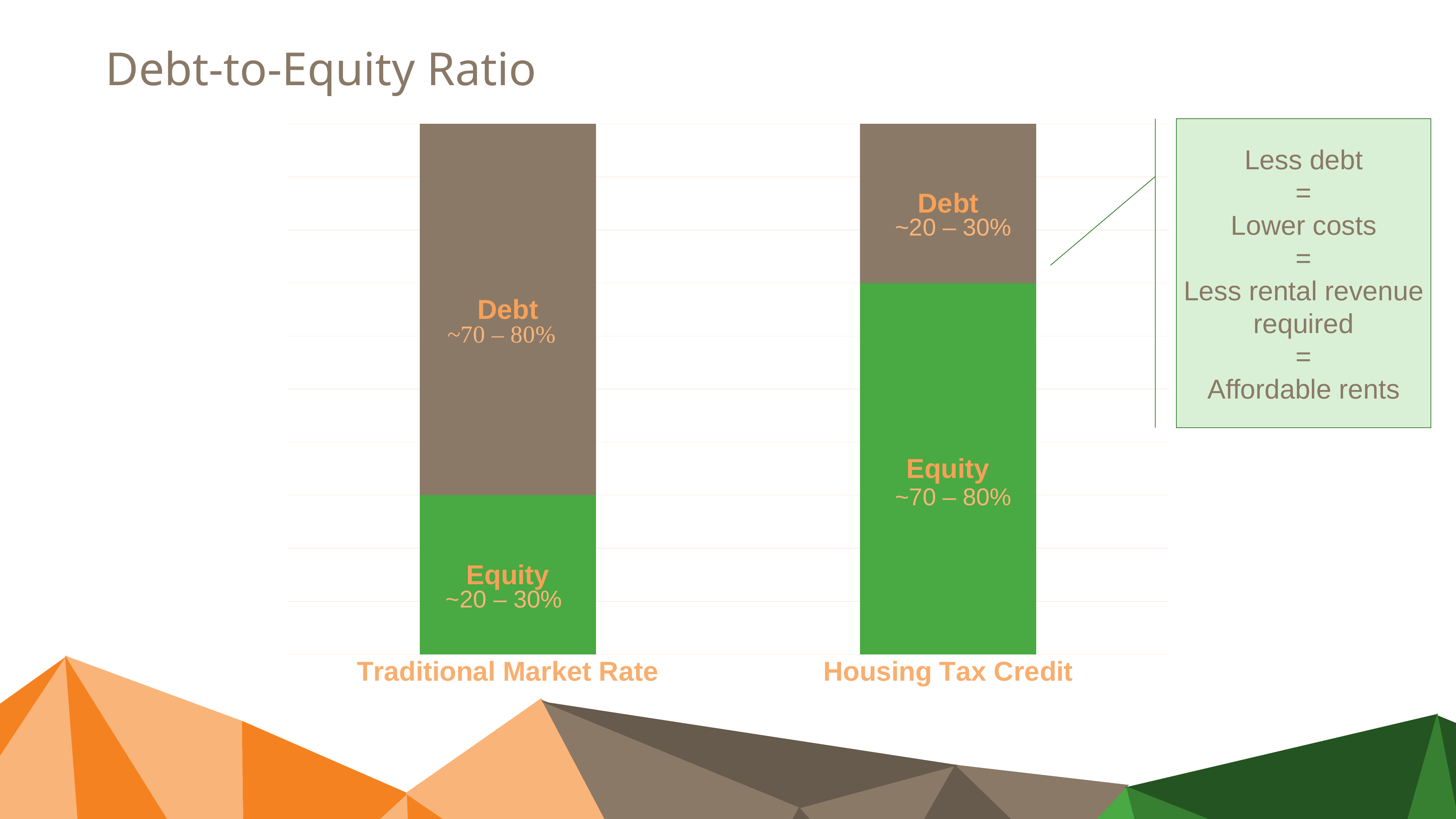
How many categories are shown along the x axis of the chart? 2 Which category has the larger Equity segment? Housing Tax Credit What colour is used for the Equity segments in the chart? Green What kind of chart is shown on the slide? Stacked bar chart In the Housing Tax Credit bar, which segment is larger, Debt or Equity? Equity What range is labelled for Equity in the Housing Tax Credit bar? ~70 – 80% What range is labelled for Debt in the Traditional Market Rate bar? ~70 – 80% In the Traditional Market Rate bar, which segment is larger, Debt or Equity? Debt What range is labelled for Equity in the Traditional Market Rate bar? ~20 – 30% What range is labelled for Debt in the Housing Tax Credit bar? ~20 – 30% What is the title of the chart on the slide? Debt-to-Equity Ratio Which category has the larger Debt segment, Traditional Market Rate or Housing Tax Credit? Traditional Market Rate